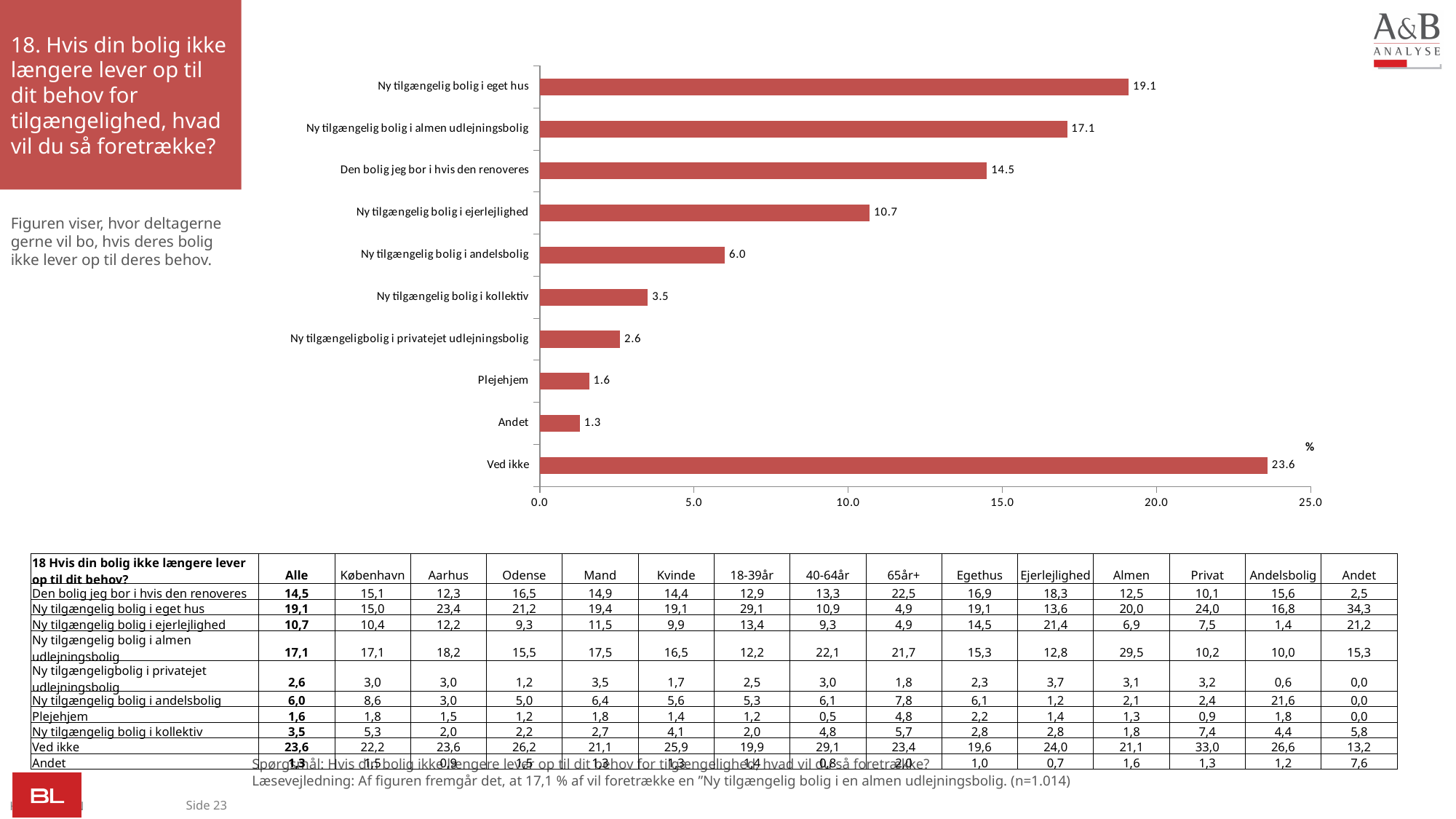
Which category has the lowest value? Andet What is the difference between 'Ved ikke' and 'Ny tilgængelig bolig i eget hus'? 4.5 What is the value for 'Ved ikke'? 23.6 What is the value for 'Plejehjem'? 1.6 What is the value for 'Ny tilgængelig bolig i andelsbolig'? 6.0 What is the value for 'Ny tilgængelig bolig i eget hus'? 19.1 Which is larger: 'Den bolig jeg bor i hvis den renoveres' or 'Ny tilgængelig bolig i ejerlejlighed'? Den bolig jeg bor i hvis den renoveres What kind of chart is shown on the slide? bar chart Which category has the highest value? Ved ikke Is the value for 'Ved ikke' greater or less than 20.0? greater What is the difference between 'Ny tilgængelig bolig i eget hus' and 'Ny tilgængelig bolig i almen udlejningsbolig'? 2.0 How many categories are shown in the chart? 10